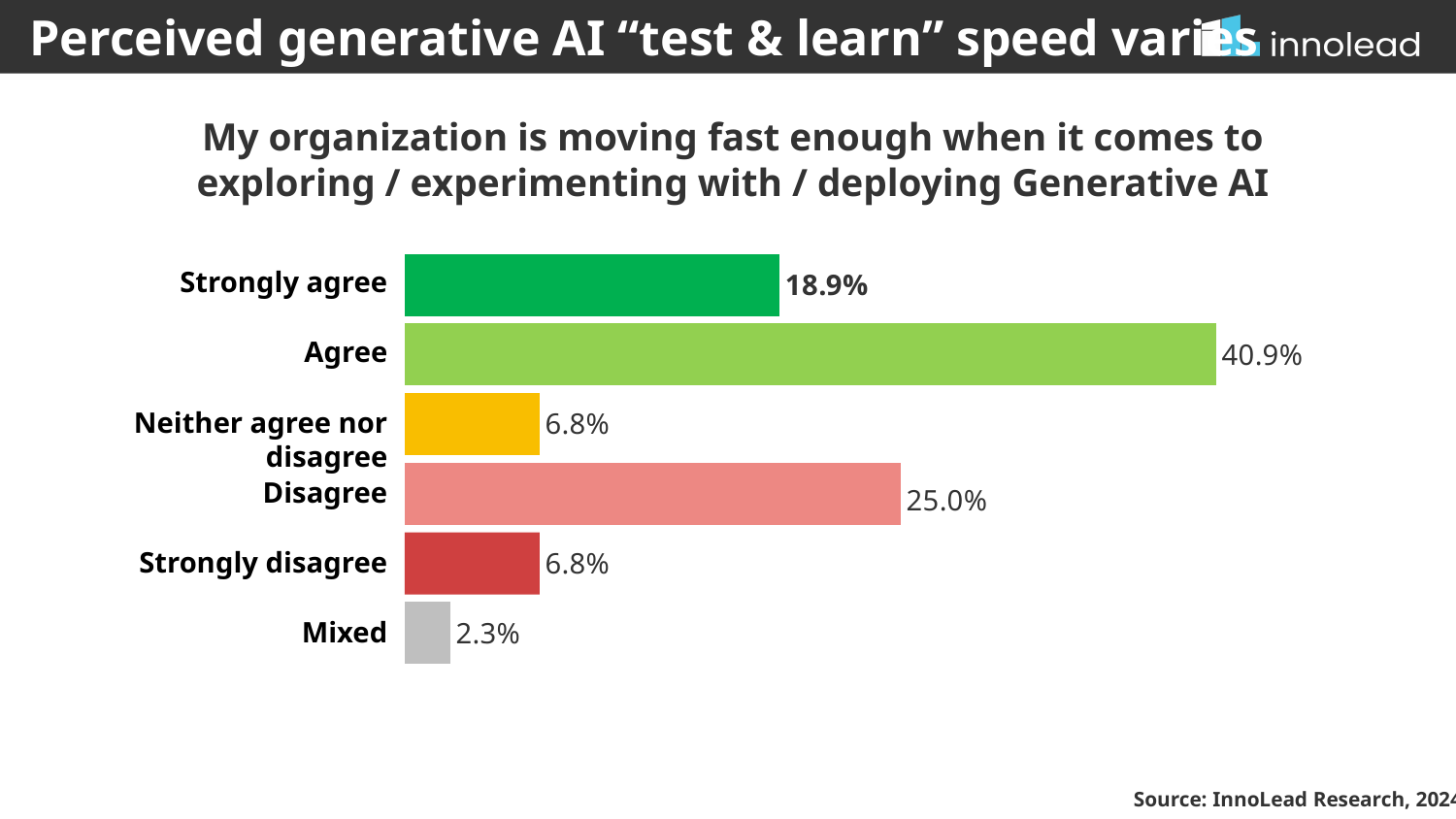
What kind of chart is shown on the slide? Bar chart What is the difference between the "Agree" and "Disagree" values? 15.9% How many response categories are shown in the chart? 6 What is the value for "Strongly agree"? 18.9% What is the value for "Mixed"? 2.3% What percentage of respondents chose "Disagree"? 25.0% What colour is the bar for "Strongly disagree"? Red Which response category has the lowest value? Mixed Which is larger, the value for "Disagree" or the value for "Strongly agree"? Disagree What percentage of respondents chose "Agree"? 40.9% Which response category has the highest value? Agree What is the difference between the "Strongly agree" and "Strongly disagree" values? 12.1%